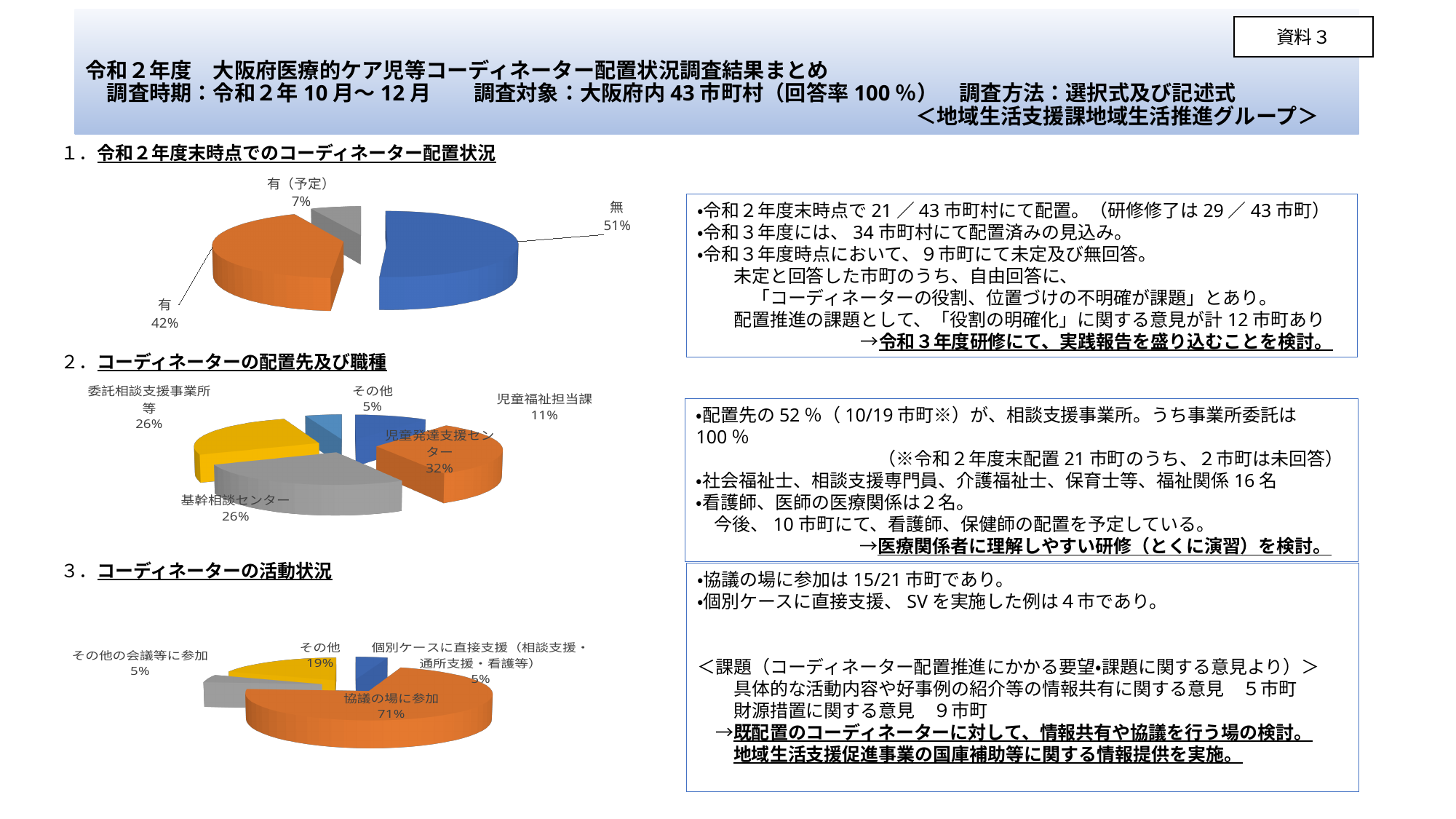
What type of chart is used in section 3 (コーディネーターの活動状況)? pie chart In the second pie chart (section 2, 配置先及び職種), what is the share for 児童発達支援センター? 32% In the first pie chart (section 1), what is the share for 有（予定）? 7% In the second pie chart (section 2), which is larger, 児童福祉担当課 or 基幹相談センター? 基幹相談センター In the first pie chart (section 1), which category has the largest share? 無 In the first pie chart (section 1), what is the difference in percentage points between 無 and 有? 9 In the first pie chart (section 1, コーディネーター配置状況), what is the share for 無? 51% How many slices does the first pie chart (section 1) have? 3 In the third pie chart (section 3, 活動状況), what is the share for 協議の場に参加? 71% In the second pie chart (section 2), which category has the smallest share? その他 How many categories are shown in the second pie chart (section 2)? 5 In the third pie chart (section 3), what is the share for その他? 19%